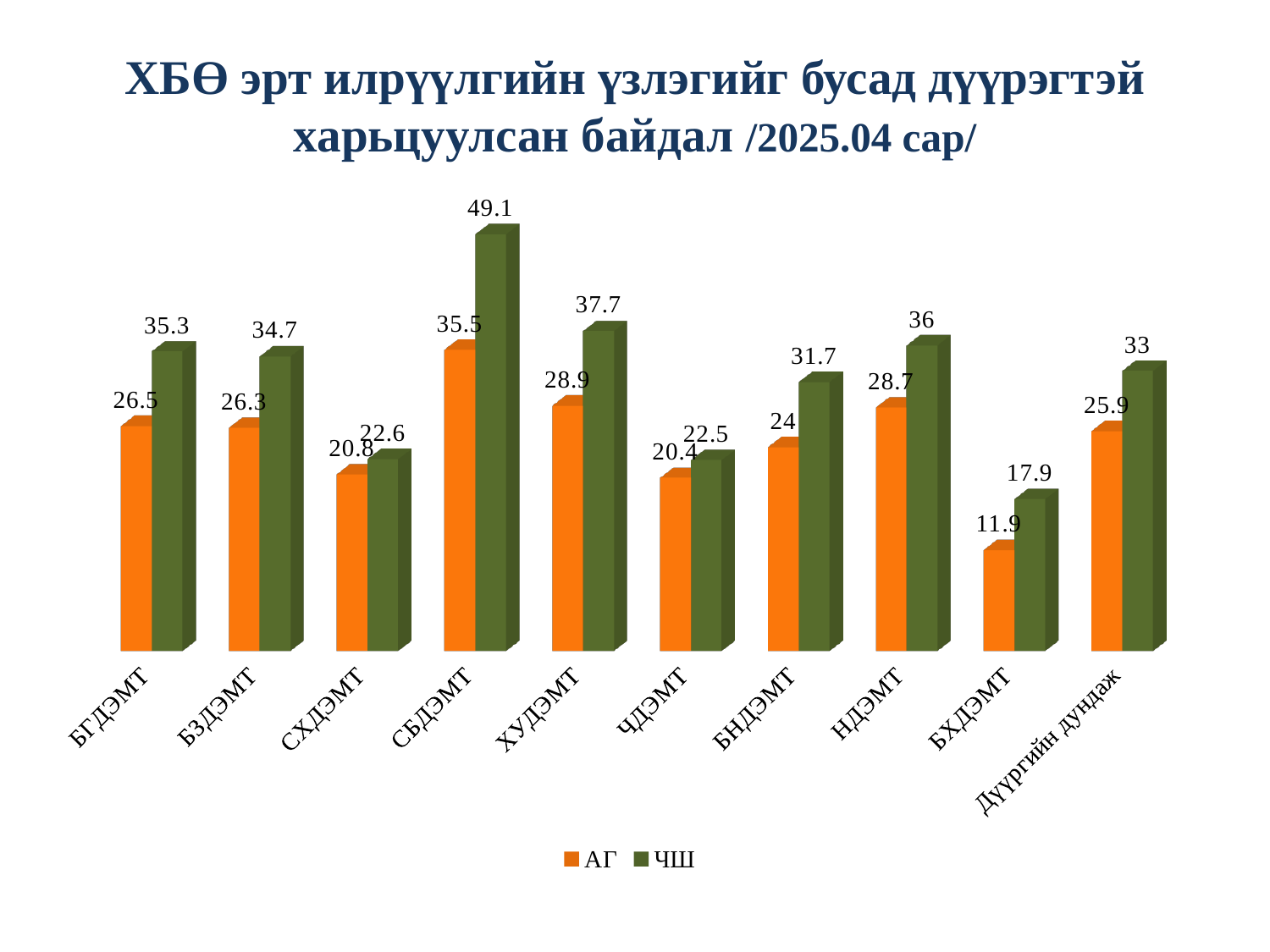
Which series is shown in orange? АГ What is the ЧШ value for НДЭМТ? 36 What is the difference between the ЧШ and АГ values for СБДЭМТ? 13.6 How many series does the legend list? 2 Which category has the lowest АГ value? БХДЭМТ How many categories are shown on the x axis? 10 Which category has the highest ЧШ value? СБДЭМТ What kind of chart is shown on the slide? Bar chart What is the АГ value for СБДЭМТ? 35.5 What is the difference between the ЧШ values for БГДЭМТ and БХДЭМТ? 17.4 Which is larger, the АГ value for ХУДЭМТ or the АГ value for БНДЭМТ? ХУДЭМТ What is the АГ value for Дүүргийн дундаж? 25.9